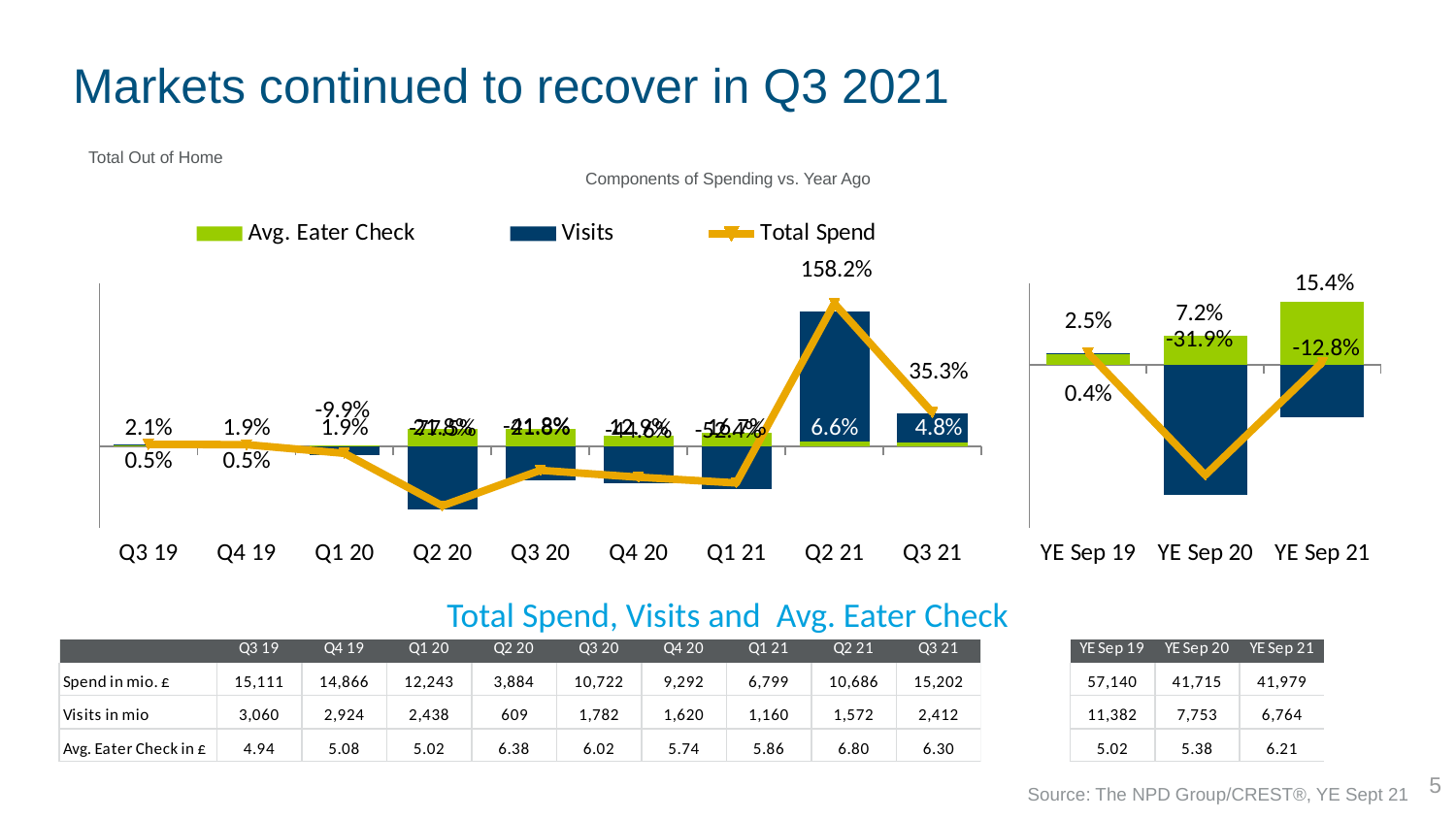
On the right chart (YE Sep 19 to YE Sep 21), what is the Visits value for YE Sep 20? -31.9% How many quarters are shown on the x axis of the left chart? 9 On the left chart, what is the Avg. Eater Check value for Q3 21? 4.8% On the left chart, what is the difference between the Visits values for Q2 21 and Q3 21? 122.9 percentage points How many series does the legend list? 3 On the left chart (Q3 19 to Q3 21), what is the Visits value for Q2 21? 158.2% On the right chart, does the Avg. Eater Check value rise or fall from YE Sep 19 to YE Sep 21? Rise What kind of chart is the left chart? Combined bar and line chart On the right chart, is the Avg. Eater Check value larger for YE Sep 20 or YE Sep 21? YE Sep 21 On the right chart, what is the Avg. Eater Check value for YE Sep 21? 15.4% On the left chart, which quarter has the highest Visits value? Q2 21 On the right chart, which period has the lowest Visits value? YE Sep 20